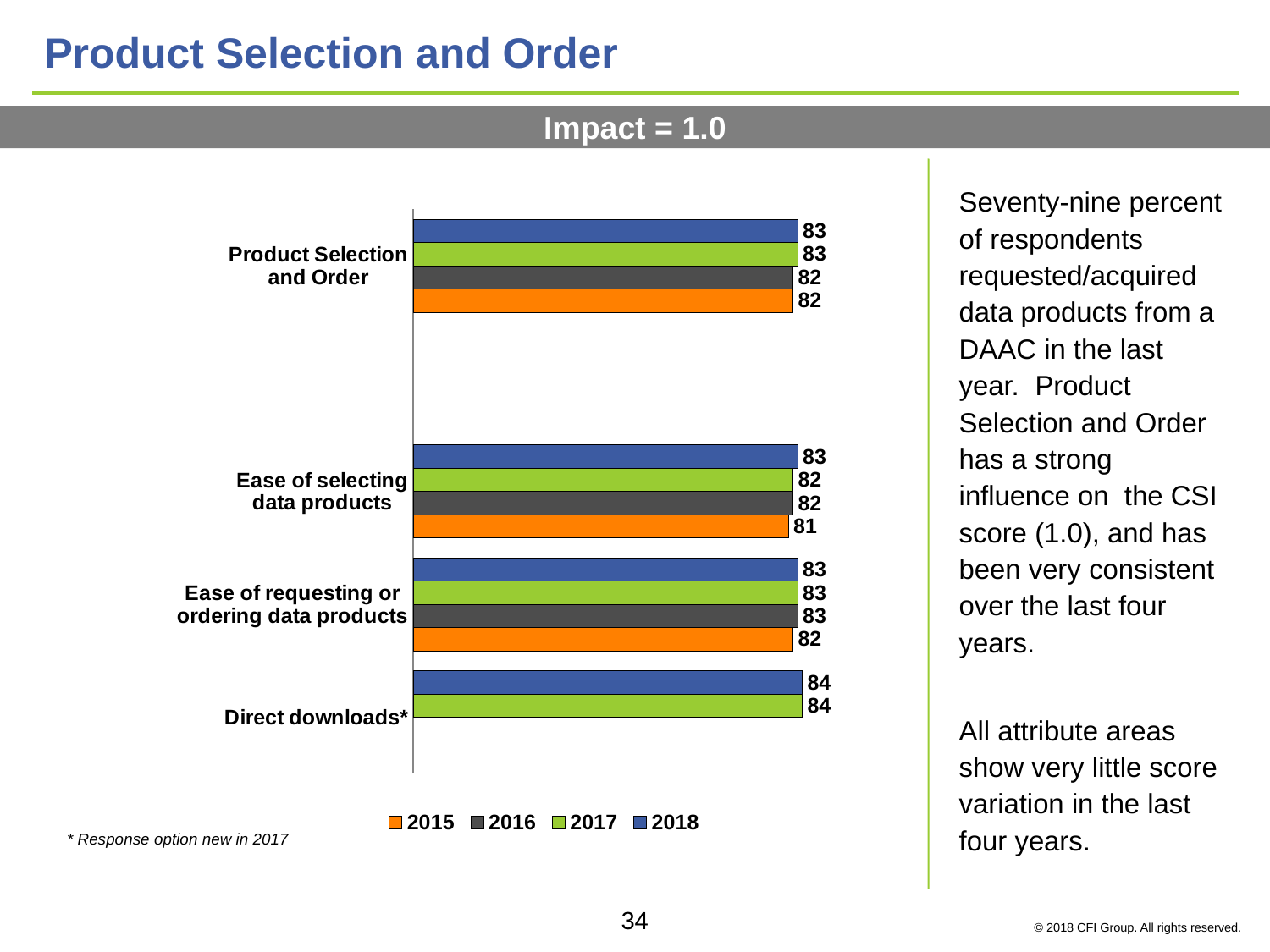
How many categories are shown on the chart? 4 What is the difference between the 2018 and 2015 values for Ease of selecting data products? 2 What is the 2017 value for Direct downloads*? 84 How many series does the legend list? 4 Which category has bars for only two of the four years? Direct downloads* Which category has the highest 2018 value? Direct downloads* What is the 2016 value for Ease of requesting or ordering data products? 83 What is the 2015 value for Ease of selecting data products? 81 What is the 2018 value for Product Selection and Order? 83 Which is larger for Product Selection and Order, the 2017 value or the 2016 value? 2017 Which category has the lowest 2015 value? Ease of selecting data products What kind of chart is shown on the slide? Bar chart